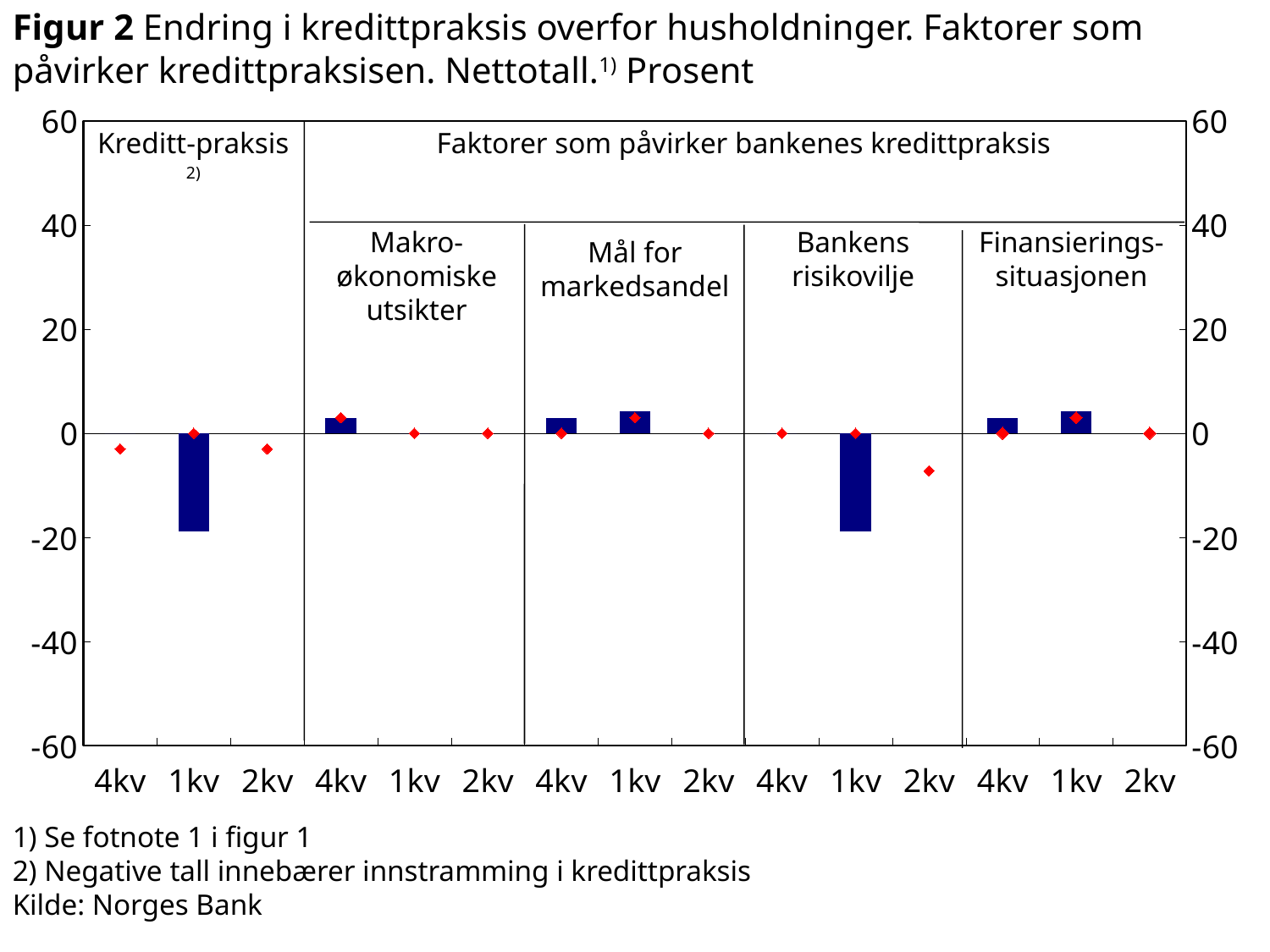
Is the bar for 4kv in the "Makro-økonomiske utsikter" panel greater or less than 20? less Which bar is larger: 1kv in the "Kreditt-praksis" panel or 4kv in the "Finansierings-situasjonen" panel? 4kv in Finansierings-situasjonen Is the bar for 1kv in the "Bankens risikovilje" panel greater or less than 0? less How many factor panels are shown under "Faktorer som påvirker bankenes kredittpraksis"? 4 How many quarter labels (bars positions) are shown along the x axis in total? 15 What is the maximum value shown on the y axis? 60 Is the bar for 1kv in the "Kreditt-praksis" panel greater or less than 0? less Which bar is larger: 1kv in the "Bankens risikovilje" panel or 1kv in the "Mål for markedsandel" panel? 1kv in Mål for markedsandel What kind of chart is shown on the slide? combination bar and line chart (bars with red diamond markers) What is the source cited for the chart? Norges Bank